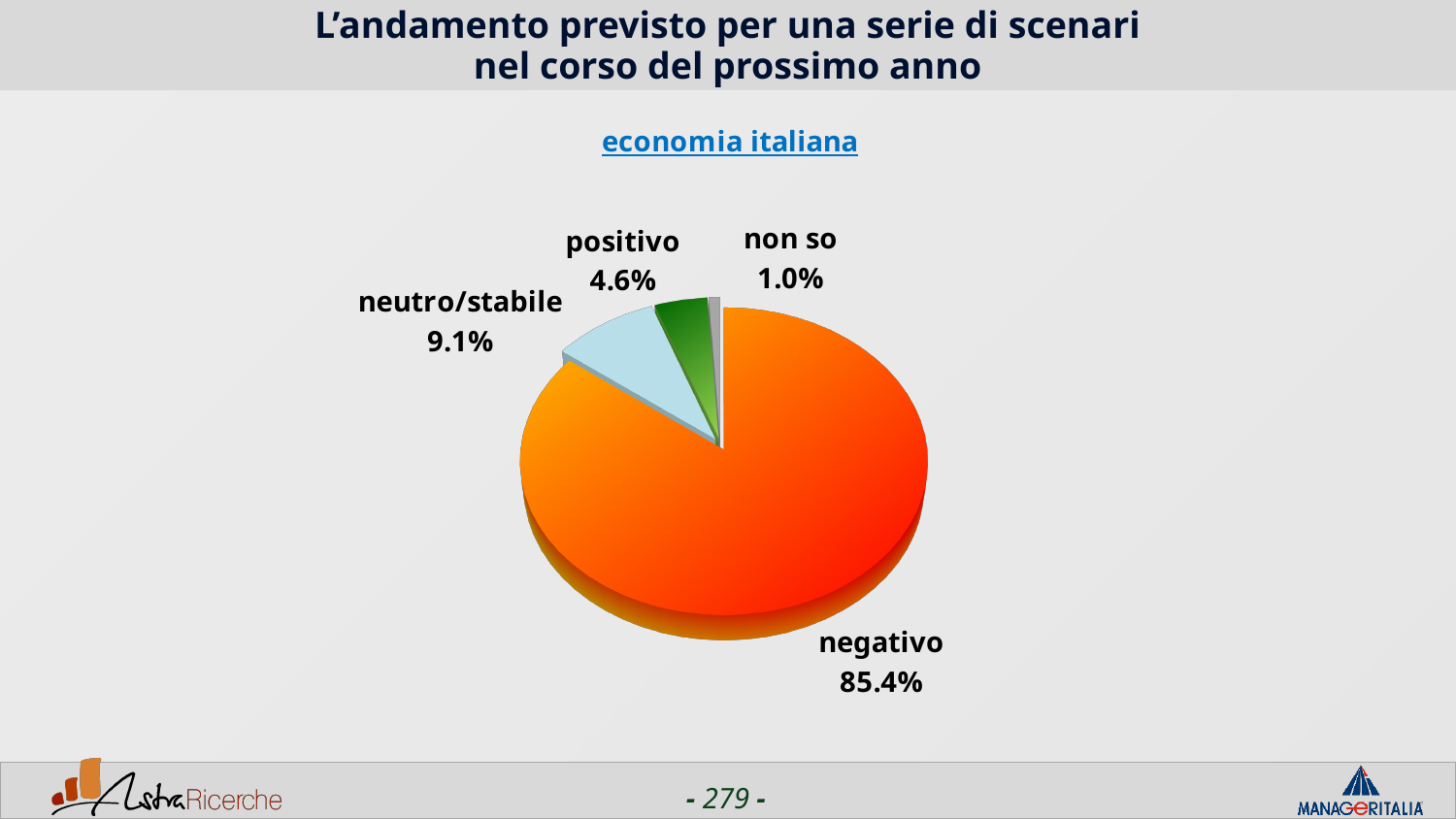
What is the difference between the values for 'neutro/stabile' and 'positivo'? 4.5% What is the difference between the values for 'negativo' and 'neutro/stabile'? 76.3% What is the value for 'negativo'? 85.4% What is the value for 'neutro/stabile'? 9.1% How many categories does the pie chart show? 4 What is the value for 'non so'? 1.0% What is the value for 'positivo'? 4.6% Which category has the largest share of the pie? negativo What kind of chart is shown on the slide? pie chart What is the subtitle shown above the pie chart? economia italiana Which category has the smallest share of the pie? non so Which is larger, the value for 'positivo' or the value for 'non so'? positivo